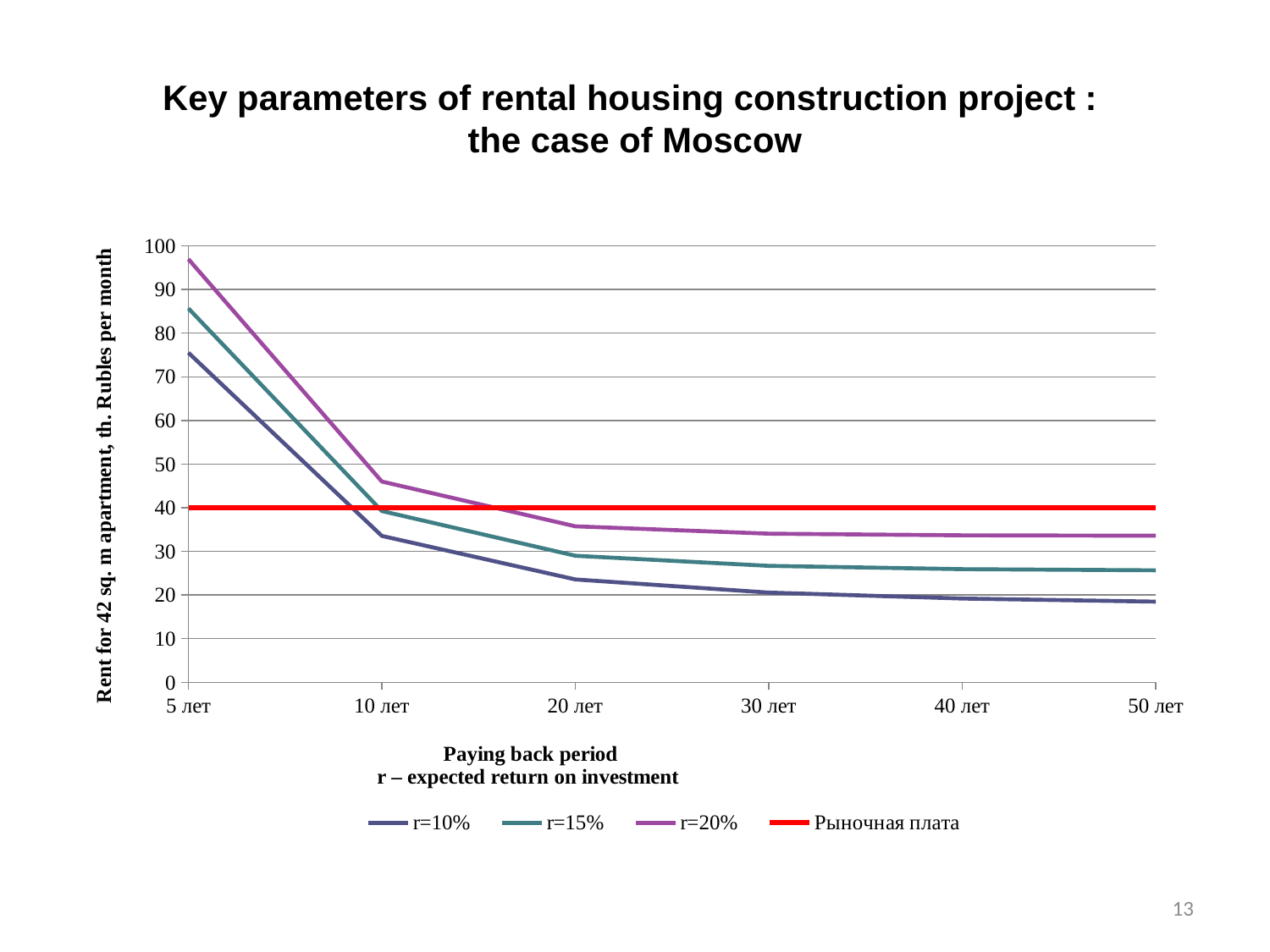
What kind of chart is shown on the slide? line chart Is the value for r=10% at 50 лет greater or less than 20? less Which series has the lowest value at 50 лет? r=10% How many paying back period categories are shown on the x axis? 6 Is the value for r=20% at 5 лет greater or less than 90? greater At 10 лет, which is larger: the value for r=20% or the value for r=10%? r=20% What is the title of the y axis? Rent for 42 sq. m apartment, th. Rubles per month Is the value for r=15% at 20 лет greater or less than 40? less What is the value of the Рыночная плата line? 40 How many series does the legend list? 4 Which series has the highest value at 5 лет? r=20% Do the values for r=20% rise or fall as the paying back period increases? fall